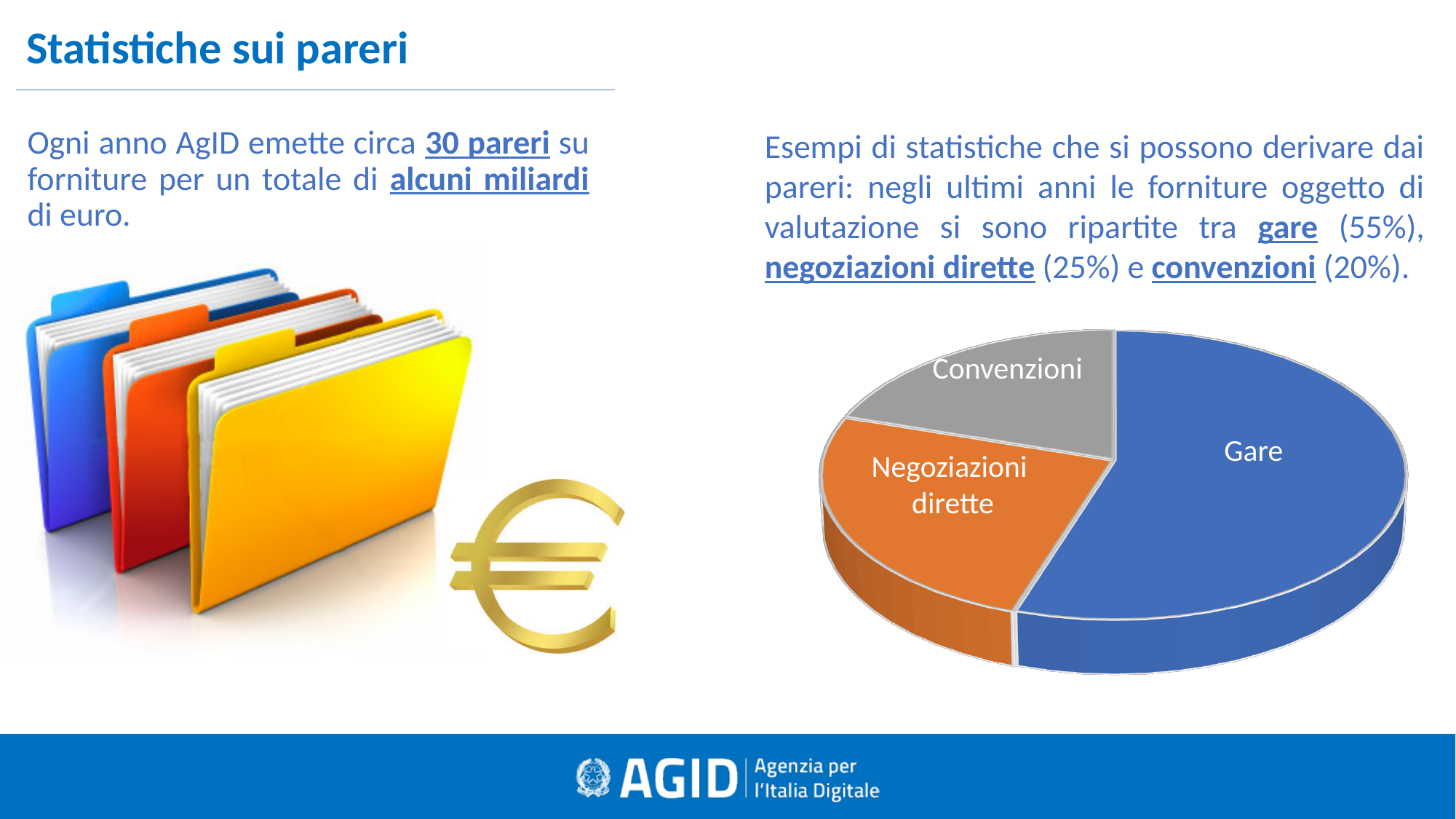
Which slice is larger in the pie chart, Negoziazioni dirette or Convenzioni? Negoziazioni dirette How many slices does the pie chart have? 3 What colour is the Gare slice in the pie chart? blue Which slice of the pie chart is the largest? Gare What colour is the Negoziazioni dirette slice in the pie chart? orange What is the difference in percentage points between the Gare share and the Convenzioni share stated on the slide? 35 Which slice is larger in the pie chart, Gare or Negoziazioni dirette? Gare According to the slide, what share of the pie does Negoziazioni dirette represent? 25% According to the slide, what share of the pie does Gare represent? 55% According to the slide, what share of the pie does Convenzioni represent? 20% What kind of chart is shown on the slide? pie chart Which slice of the pie chart is the smallest? Convenzioni